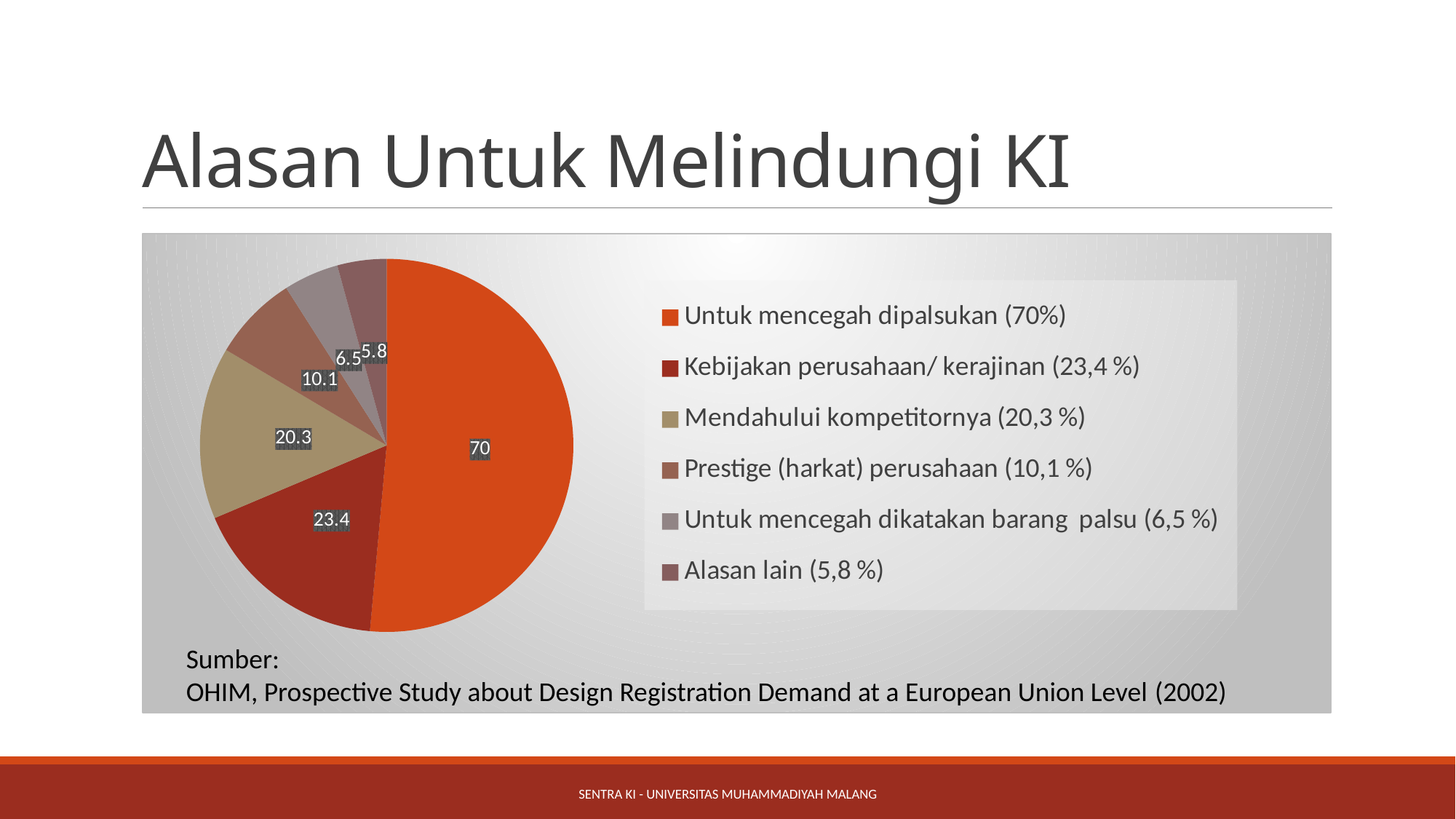
Which category has the smallest slice of the pie? Alasan lain What is the data label on the slice for "Kebijakan perusahaan/ kerajinan"? 23.4 Which category has the largest slice of the pie? Untuk mencegah dipalsukan What is the data label on the slice for "Prestige (harkat) perusahaan"? 10.1 How many slices does the pie chart have? 6 What is the data label on the slice for "Mendahului kompetitornya"? 20.3 What kind of chart is shown on the slide? pie chart What is the difference between the data labels for "Untuk mencegah dipalsukan" and "Kebijakan perusahaan/ kerajinan"? 46.6 What is the data label on the slice for "Untuk mencegah dipalsukan"? 70 What is the data label on the slice for "Alasan lain"? 5.8 Which is larger: the slice for "Mendahului kompetitornya" or the slice for "Prestige (harkat) perusahaan"? Mendahului kompetitornya What percentage does the legend give for "Untuk mencegah dikatakan barang palsu"? 6,5 %